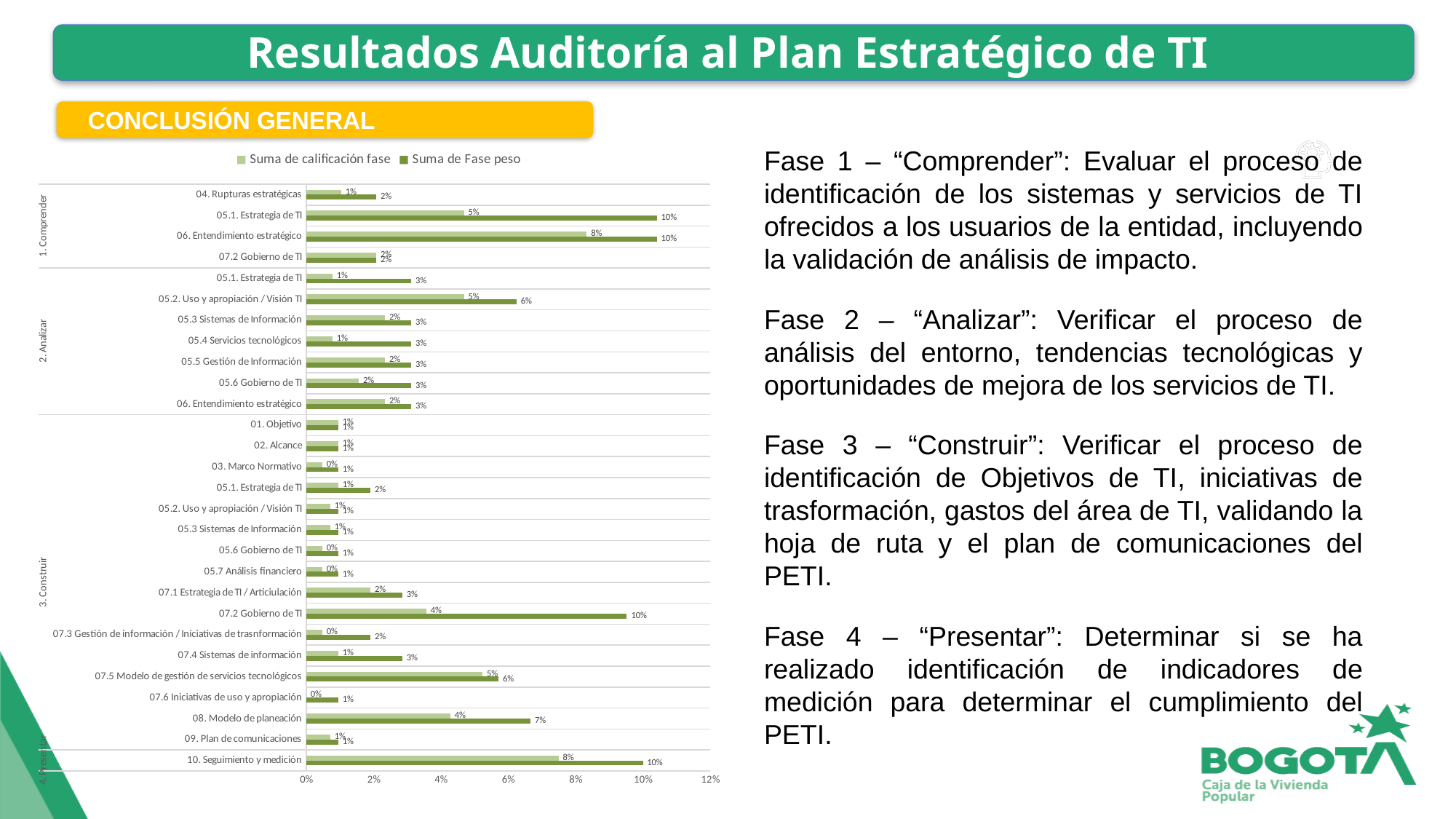
What is the Suma de calificación fase value for 07.2 Gobierno de TI in the 3. Construir phase? 4% What is the difference between Suma de Fase peso and Suma de calificación fase for 05.1. Estrategia de TI in the 1. Comprender phase? 5% What kind of chart is shown on the slide? Bar chart How many series does the chart legend list? 2 What is the Suma de calificación fase value for 06. Entendimiento estratégico in the 1. Comprender phase? 8% What is the difference between Suma de Fase peso and Suma de calificación fase for 07.2 Gobierno de TI in the 3. Construir phase? 6% Which is larger: the Suma de calificación fase for 07.5 Modelo de gestión de servicios tecnológicos or for 07.1 Estrategia de TI / Articulación, both in the 3. Construir phase? 07.5 Modelo de gestión de servicios tecnológicos What are the two series named in the chart legend? Suma de calificación fase and Suma de Fase peso How many categories are listed in the 3. Construir phase of the chart? 16 Within the 2. Analizar phase, which category has the highest Suma de calificación fase value? 05.2. Uso y apropiación / Visión TI What is the Suma de Fase peso value for 08. Modelo de planeación in the 3. Construir phase? 7% What is the Suma de Fase peso value for 10. Seguimiento y medición in the 4. Presentar phase? 10%